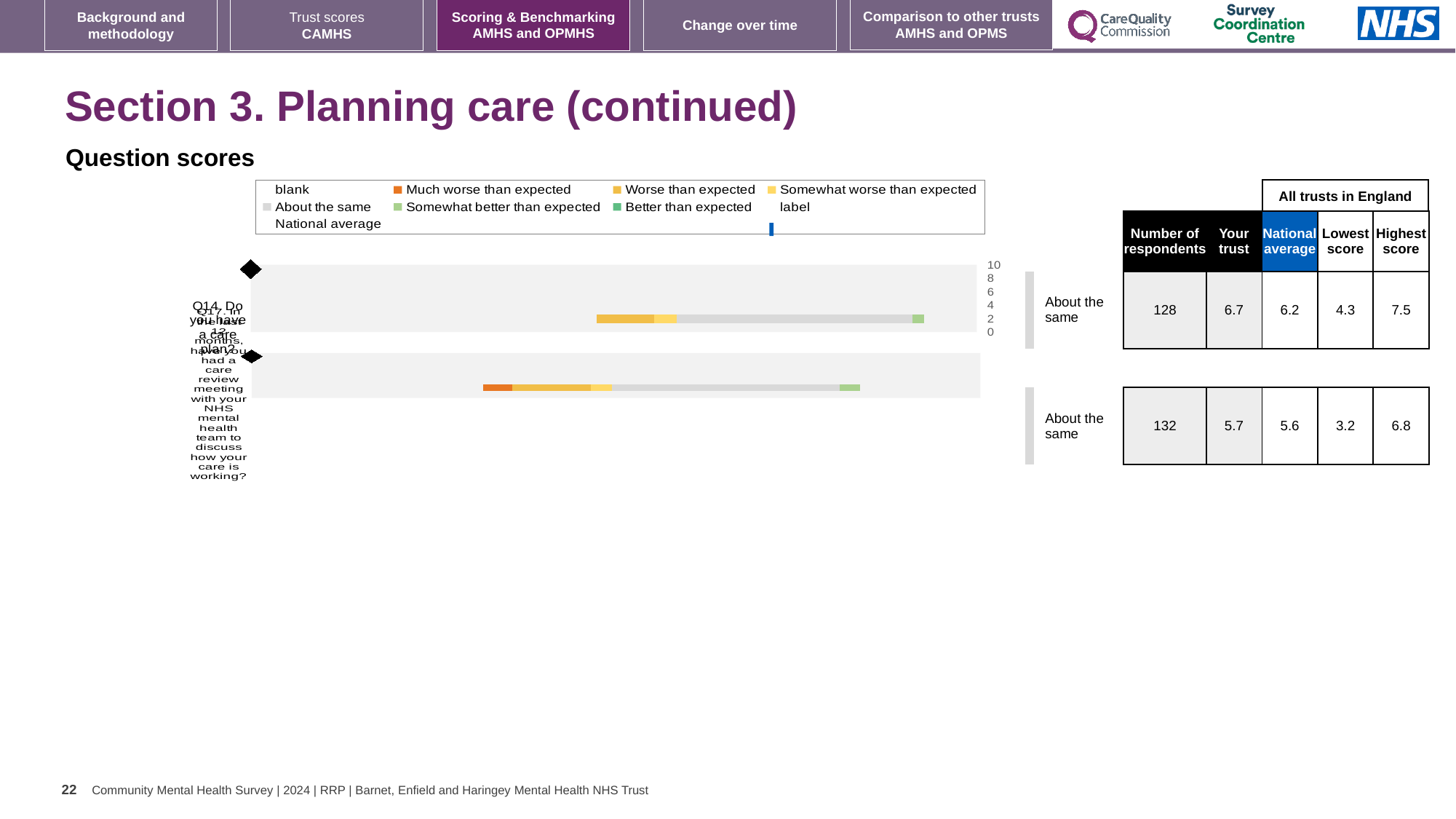
In the table next to the chart, what is the highest score for Q17? 6.8 In the table next to the chart, what is the lowest score for Q14? 4.3 In the table next to the chart, what is the number of respondents for Q14? 128 In the table next to the chart, what is the 'Your trust' score for Q14? 6.7 What benchmark category is shown for both Q14 and Q17 beside the chart? About the same How many legend entries contain the word 'expected'? 5 Which legend entry is shown in orange? Much worse than expected Which question has the higher 'Your trust' score in the table, Q14 or Q17? Q14 What kind of chart is shown under 'Question scores'? bar chart In the table next to the chart, what is the national average for Q17? 5.6 How many questions (bars) are plotted in the chart? 2 What is the difference between the 'Your trust' score and the national average for Q14 in the table? 0.5